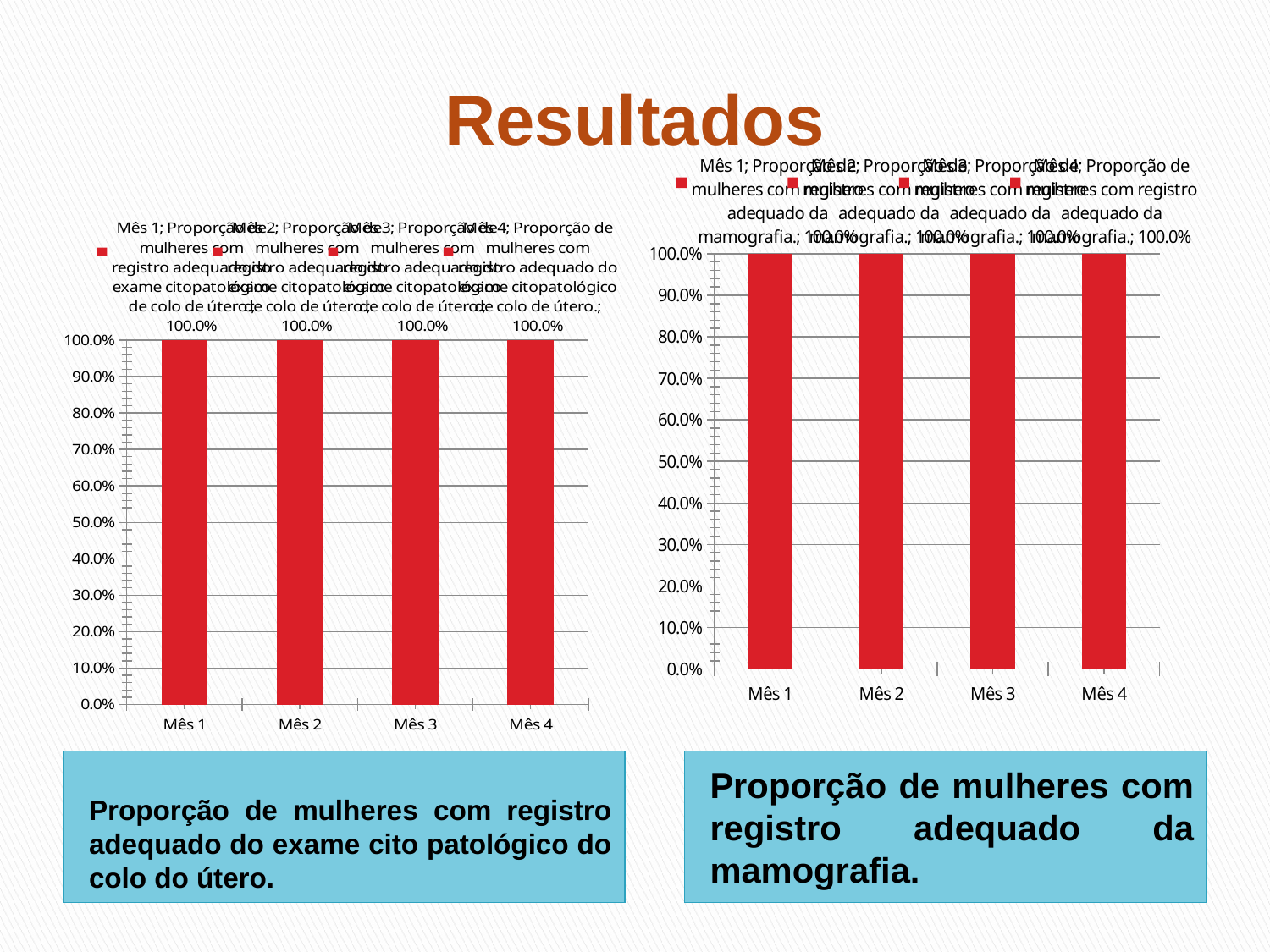
In the left chart, do the values rise, fall, or stay the same from Mês 1 to Mês 4? Stay the same In the right chart (registro adequado da mamografia), what is the value for Mês 3? 100.0% In the right chart (registro adequado da mamografia), what is the value for Mês 2? 100.0% How many categories (months) are plotted in the left chart? 4 In the right chart, is the value for Mês 1 greater or less than 90.0%? greater In the left chart (registro adequado do exame citopatológico do colo do útero), what is the value for Mês 4? 100.0% How many bars are shown in the right chart (registro adequado da mamografia)? 4 What kind of chart is the left chart on the slide? Bar chart What kind of chart is the right chart on the slide? Bar chart In the left chart (registro adequado do exame citopatológico do colo do útero), what is the value for Mês 1? 100.0% What colour are the bars in both charts on the slide? Red In the right chart, do the values rise, fall, or stay the same from Mês 1 to Mês 4? Stay the same